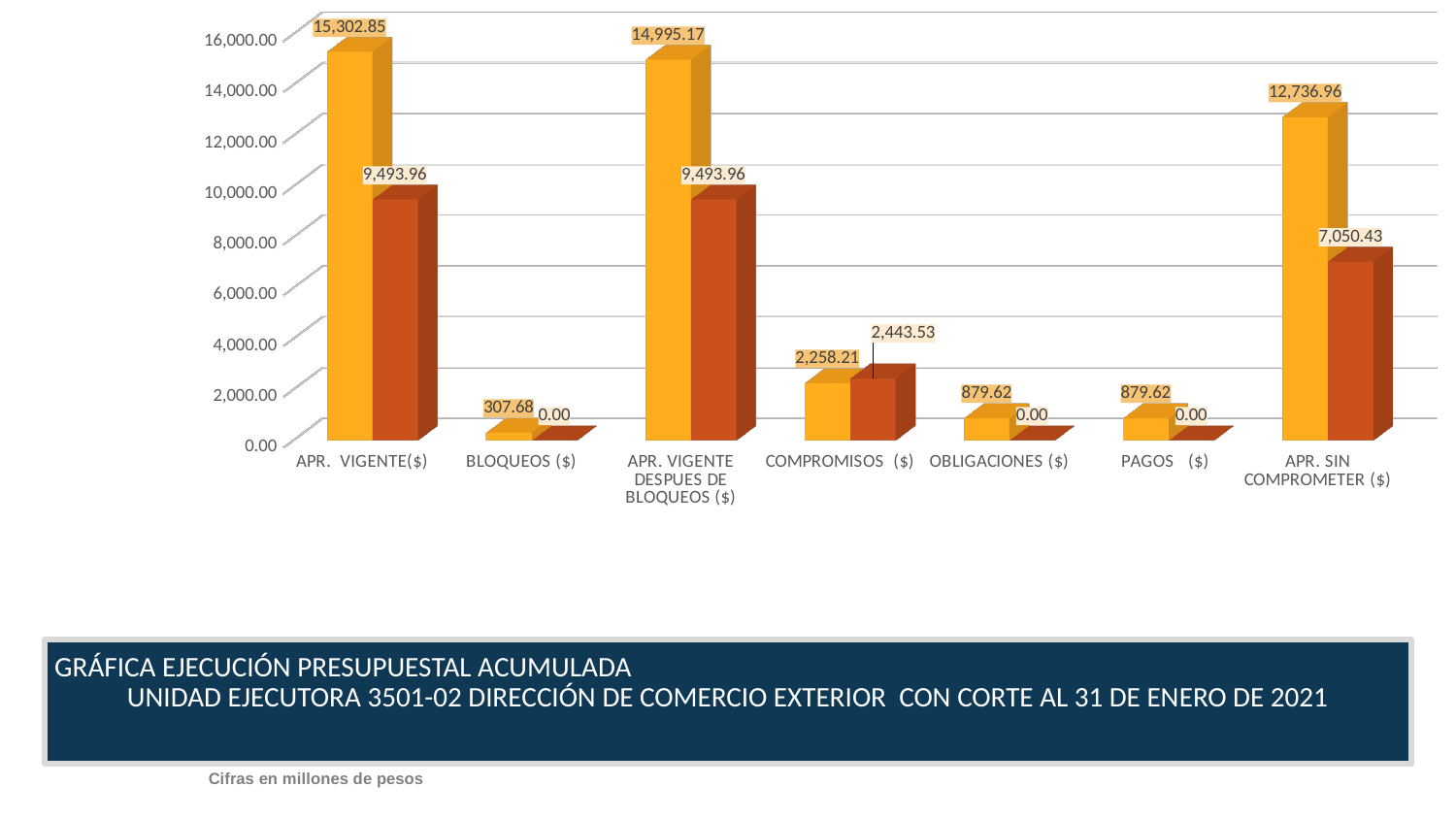
What is the difference between the yellow bars for APR. VIGENTE($) and APR. VIGENTE DESPUES DE BLOQUEOS ($)? 307.68 Which category has the highest yellow bar? APR. VIGENTE($) What is the value of the orange bar for APR. SIN COMPROMETER ($)? 7,050.43 How many categories are shown on the x axis? 7 What is the value of the orange bar for COMPROMISOS ($)? 2,443.53 Which category has the lowest yellow bar? BLOQUEOS ($) What is the value of the yellow bar for BLOQUEOS ($)? 307.68 What is the value of the yellow bar for APR. VIGENTE($)? 15,302.85 For COMPROMISOS ($), which bar is larger, the yellow or the orange one? orange What kind of chart is shown on the slide? bar chart According to the note below the chart, in what units are the figures expressed? millones de pesos What is the difference between the yellow and orange bars for APR. SIN COMPROMETER ($)? 5,686.53